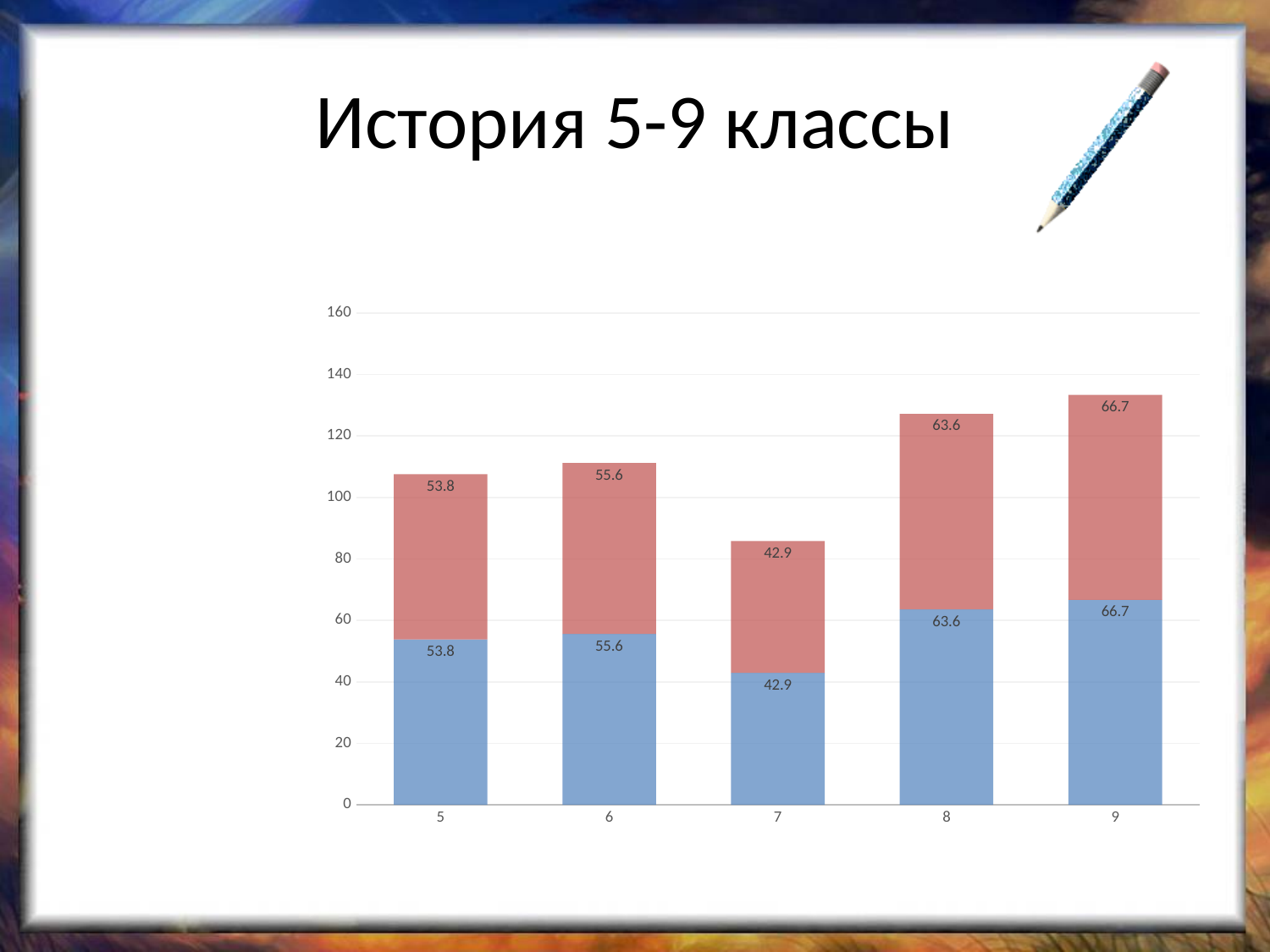
Is the total height of the stacked bar for category 7 greater or less than 100? less What kind of chart is shown on the slide? bar chart What is the value of the blue segment for category 7? 42.9 What is the total of the stacked bar for category 8? 127.2 What is the title of the slide containing the chart? История 5-9 классы Which category has the tallest stacked bar? 9 How many categories are shown on the x axis of the chart? 5 Is the total height of the stacked bar for category 9 greater or less than 120? greater Which has the larger blue segment value, category 5 or category 6? 6 Which category has the shortest stacked bar? 7 What is the difference between the blue segment values for category 9 and category 7? 23.8 What is the value of the red segment for category 9? 66.7